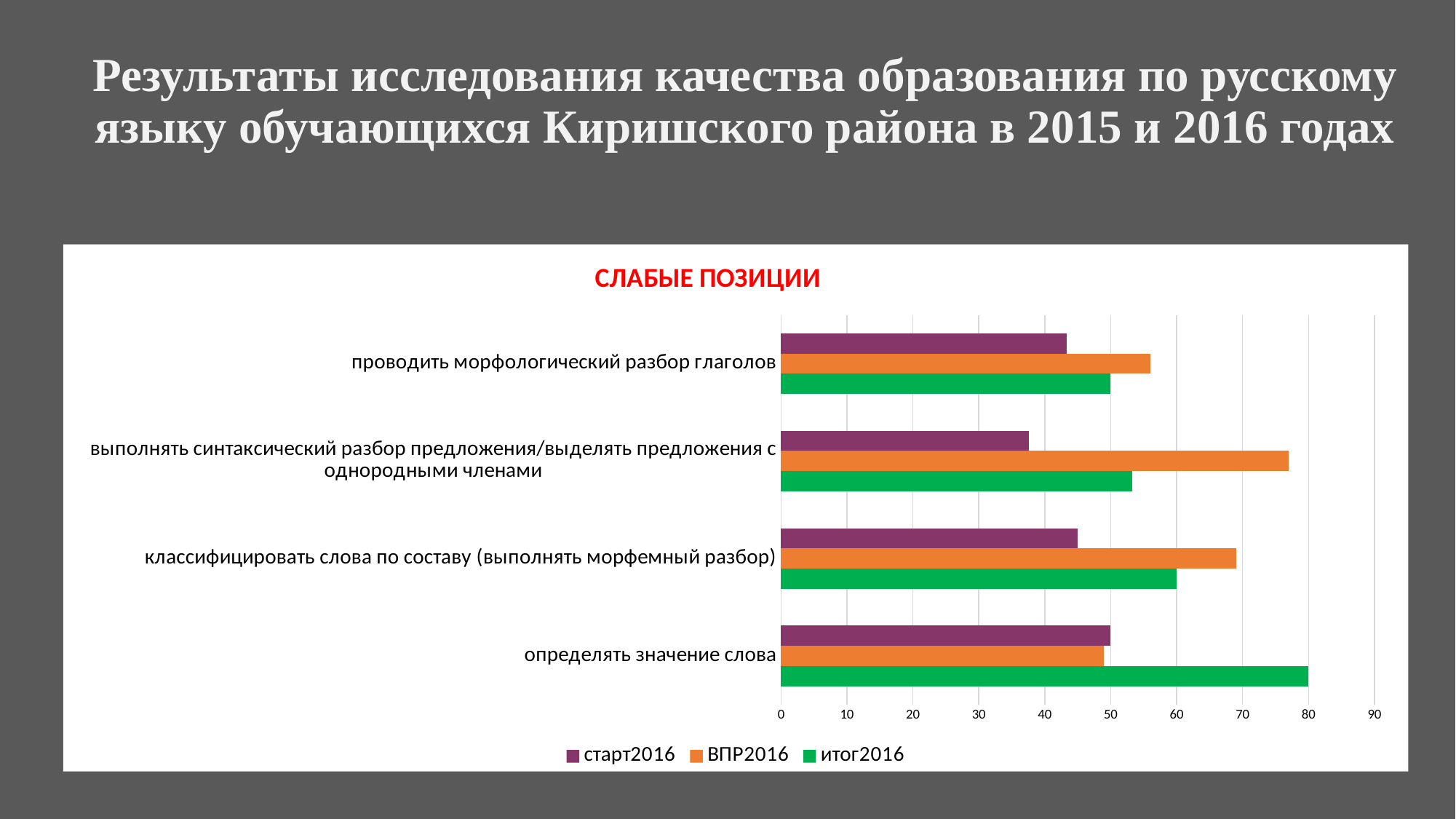
How many categories are plotted on the chart? 4 What is the title of the chart? СЛАБЫЕ ПОЗИЦИИ For 'определять значение слова', which is larger: старт2016 or итог2016? итог2016 For 'классифицировать слова по составу (выполнять морфемный разбор)', which is larger: ВПР2016 or старт2016? ВПР2016 Which category has the lowest старт2016 value? выполнять синтаксический разбор предложения/выделять предложения с однородными членами How many series does the legend list? 3 Is the ВПР2016 value for 'выполнять синтаксический разбор предложения/выделять предложения с однородными членами' greater or less than 70? greater What is the value of итог2016 for 'определять значение слова'? 80 Is the старт2016 value for 'проводить морфологический разбор глаголов' greater or less than 50? less What kind of chart is shown on the slide? bar chart Which category has the highest ВПР2016 value? выполнять синтаксический разбор предложения/выделять предложения с однородными членами Which category has the highest итог2016 value? определять значение слова